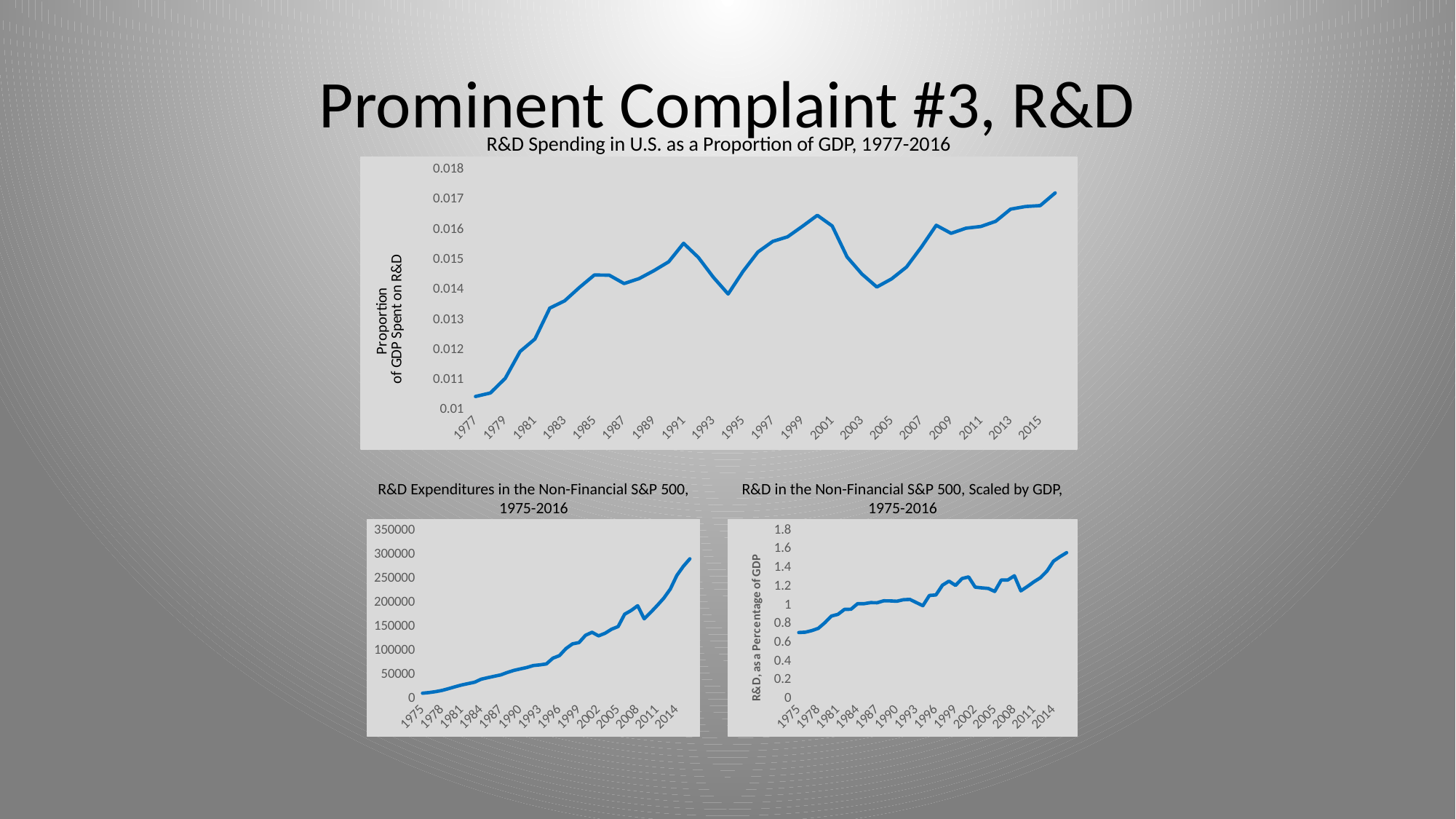
In the bottom-left chart 'R&D Expenditures in the Non-Financial S&P 500, 1975-2016', do the values generally rise or fall over time? rise In the bottom-left chart 'R&D Expenditures in the Non-Financial S&P 500, 1975-2016', is the value for 2016 greater or less than 250000? greater In the top chart 'R&D Spending in U.S. as a Proportion of GDP, 1977-2016', is the value for 1977 greater or less than 0.011? less What is the y-axis label of the top chart 'R&D Spending in U.S. as a Proportion of GDP, 1977-2016'? Proportion of GDP Spent on R&D In the top chart 'R&D Spending in U.S. as a Proportion of GDP, 1977-2016', is the value for 2016 greater or less than 0.016? greater In the top chart 'R&D Spending in U.S. as a Proportion of GDP, 1977-2016', do the values generally rise or fall from 1977 to 2016? rise What kind of chart is the top chart titled 'R&D Spending in U.S. as a Proportion of GDP, 1977-2016'? line chart What is the y-axis label of the bottom-right chart 'R&D in the Non-Financial S&P 500, Scaled by GDP, 1975-2016'? R&D, as a Percentage of GDP